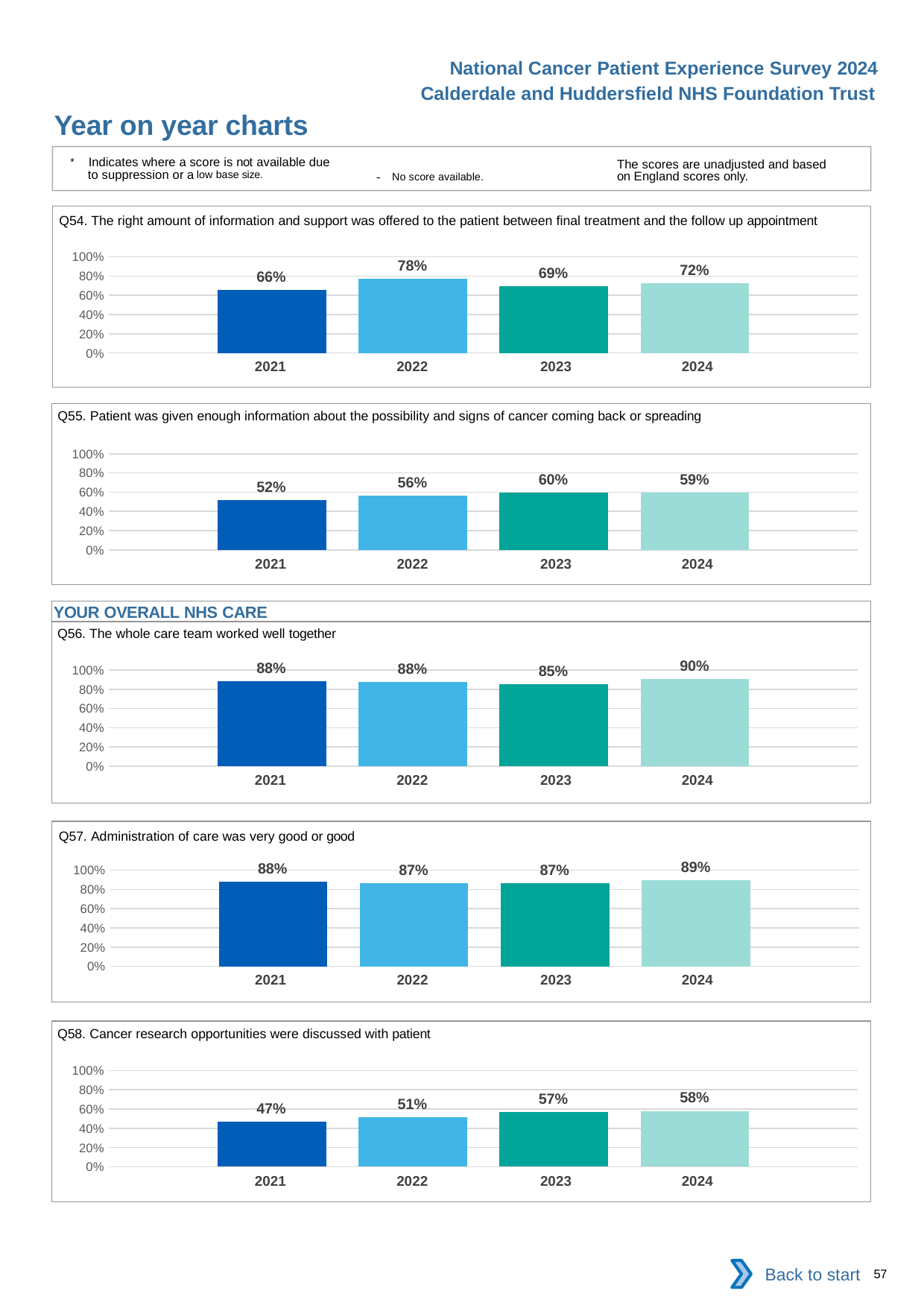
What kind of chart is the Q56 chart? bar chart How many years are shown in the Q55 chart? 4 In the Q58 chart, do the values rise or fall from 2021 to 2024? rise In the Q57 chart, what is the value for 2024? 89% In the Q55 chart, what is the value for 2021? 52% In the Q54 chart, what is the value for 2022? 78% In the Q58 chart, what is the difference between the 2024 and 2021 values? 11% In the Q58 chart, which year has the lowest value? 2021 In the Q54 chart, what is the difference between the 2022 and 2021 values? 12% In the Q56 chart, what is the value for 2024? 90% In the Q55 chart, which year has the highest value? 2023 In the Q57 chart, which is larger, the value for 2021 or the value for 2022? 2021